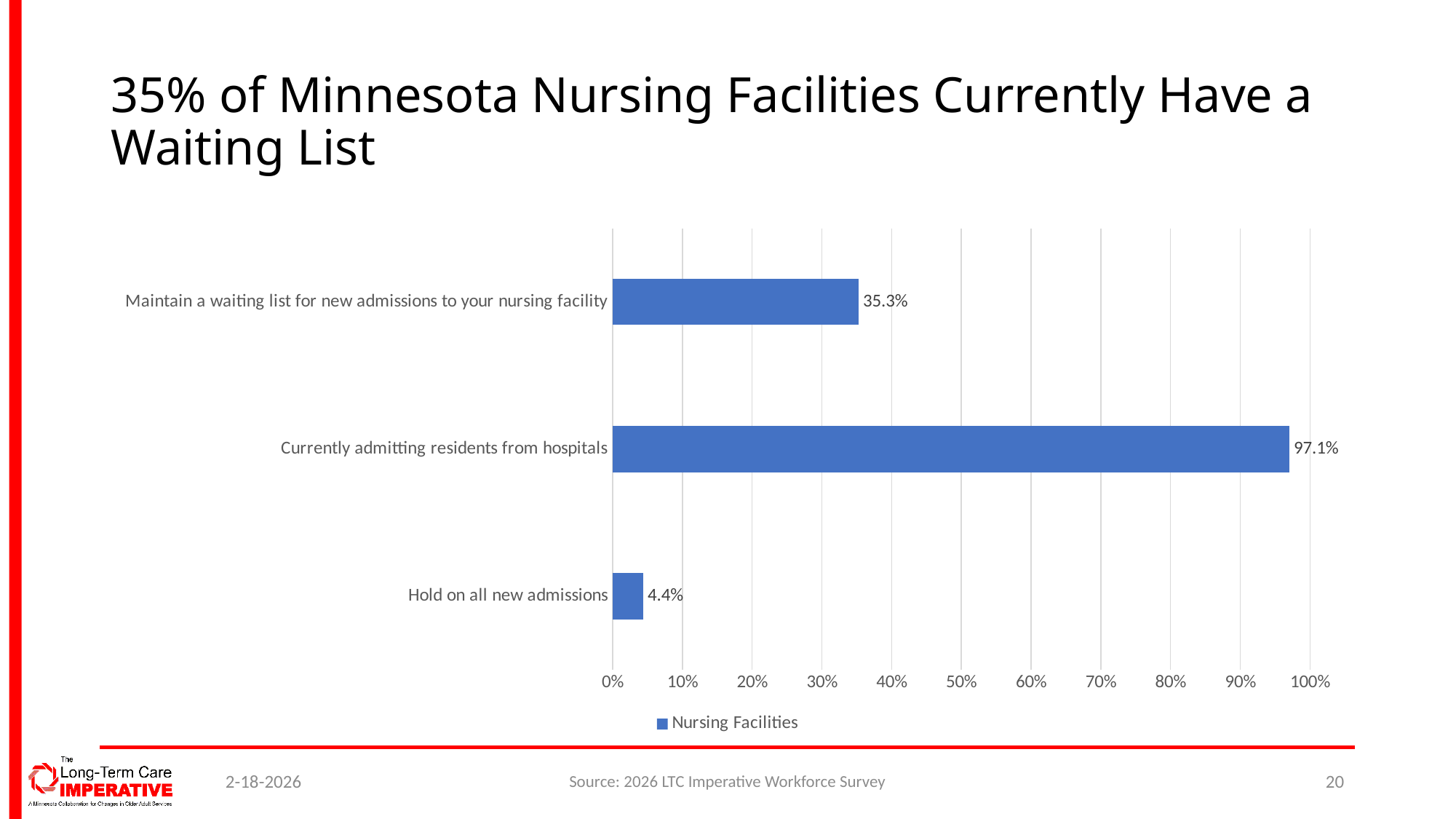
Which is larger: the value for 'Maintain a waiting list for new admissions to your nursing facility' or the value for 'Hold on all new admissions'? Maintain a waiting list for new admissions to your nursing facility What series name does the legend show? Nursing Facilities What kind of chart is shown on the slide? Bar chart Which category has the highest value? Currently admitting residents from hospitals Is the value for 'Currently admitting residents from hospitals' greater or less than 90%? greater What percentage of nursing facilities maintain a waiting list for new admissions? 35.3% Which category has the lowest value? Hold on all new admissions How many categories are shown in the chart? 3 What is the difference between the value for 'Currently admitting residents from hospitals' and the value for 'Maintain a waiting list for new admissions to your nursing facility'? 61.8% What percentage of nursing facilities are currently admitting residents from hospitals? 97.1% What percentage of nursing facilities have a hold on all new admissions? 4.4% What is the difference between the value for 'Maintain a waiting list for new admissions to your nursing facility' and the value for 'Hold on all new admissions'? 30.9%